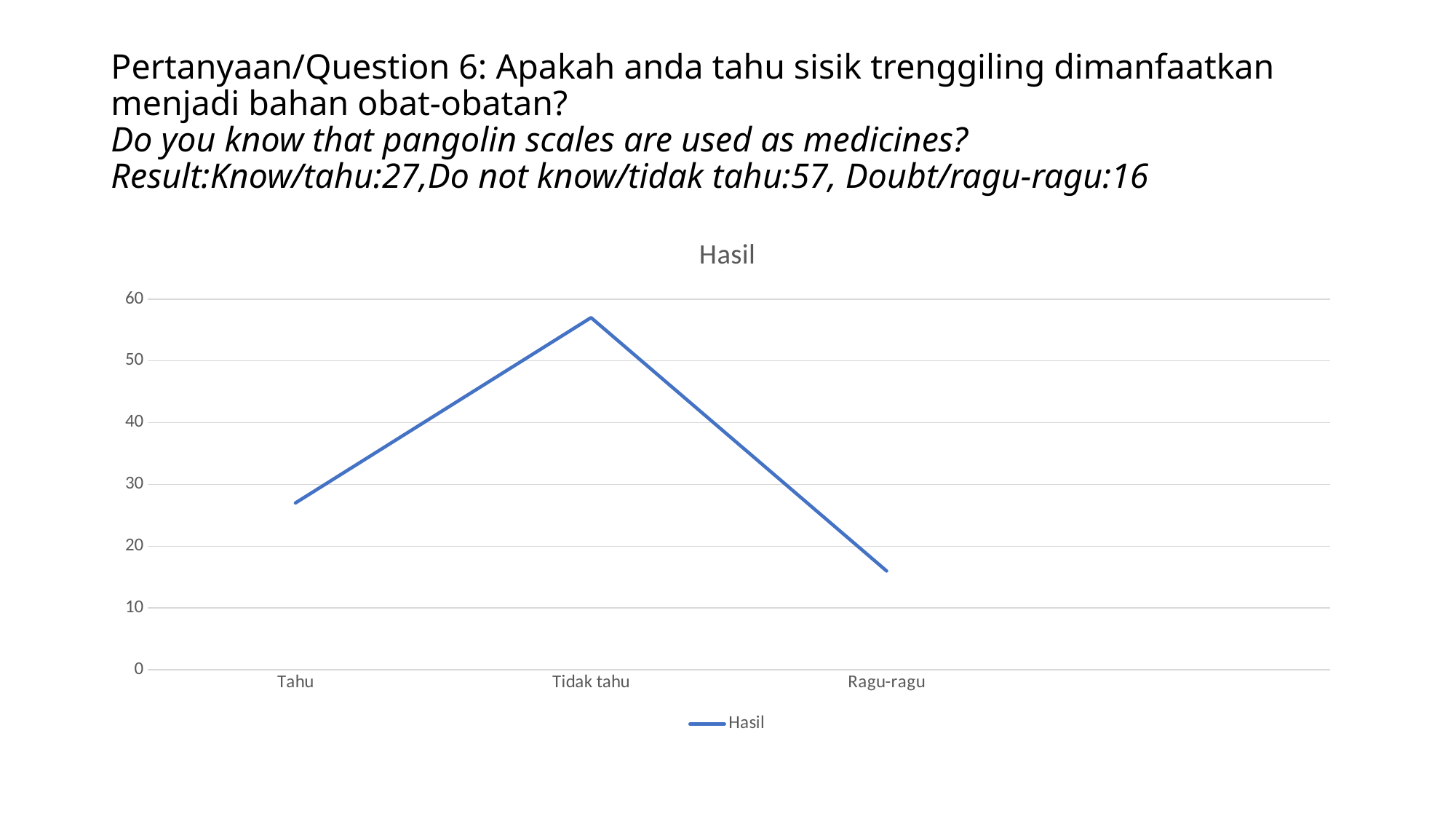
What is the title of the chart? Hasil What is the value for Tidak tahu? 57 Which is larger, the value for Tahu or the value for Ragu-ragu? Tahu How many series does the chart legend list? 1 How many categories are plotted on the x axis of the chart? 3 Which category has the highest value? Tidak tahu Is the value for Ragu-ragu greater or less than 20? less Which category has the lowest value? Ragu-ragu What is the difference between the values for Tidak tahu and Tahu? 30 What is the value for Tahu? 27 What type of chart is shown on the slide? line chart What is the value for Ragu-ragu? 16